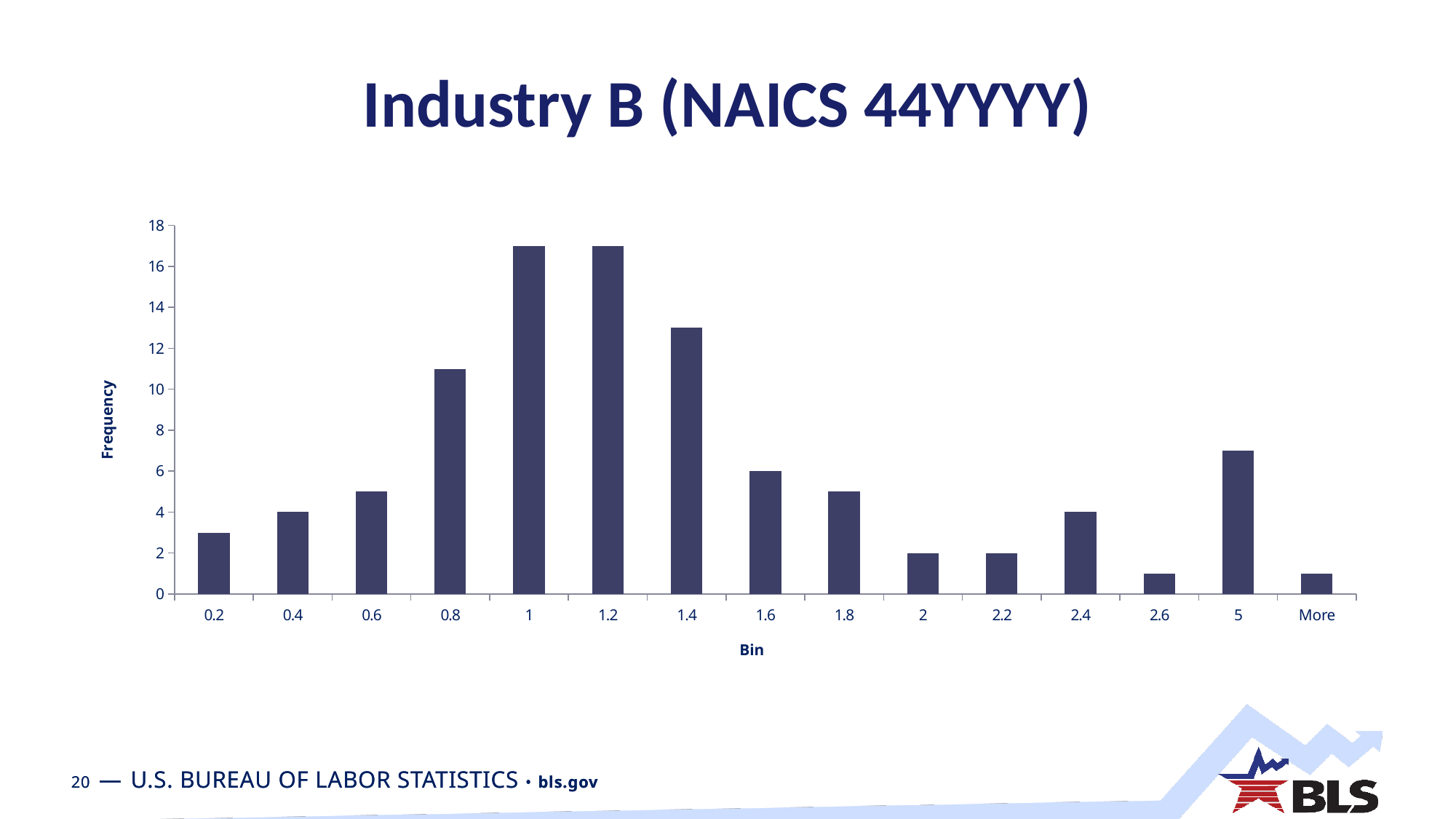
What is the title of the chart? Industry B (NAICS 44YYYY) What is the frequency for bin 1.6? 6 What is the label of the vertical axis? Frequency Which bin has the higher frequency, 0.8 or 1.4? 1.4 Is the frequency for bin 0.8 greater or less than 10? greater Do the frequencies rise or fall from bin 1.2 to bin 2.2? fall What is the frequency for bin 2.4? 4 How many bins are shown along the x axis? 15 Is the frequency for bin 1.4 greater or less than 12? greater What is the frequency for bin 0.4? 4 What type of chart is shown on the slide? bar chart Is the frequency for bin 5 greater or less than 8? less